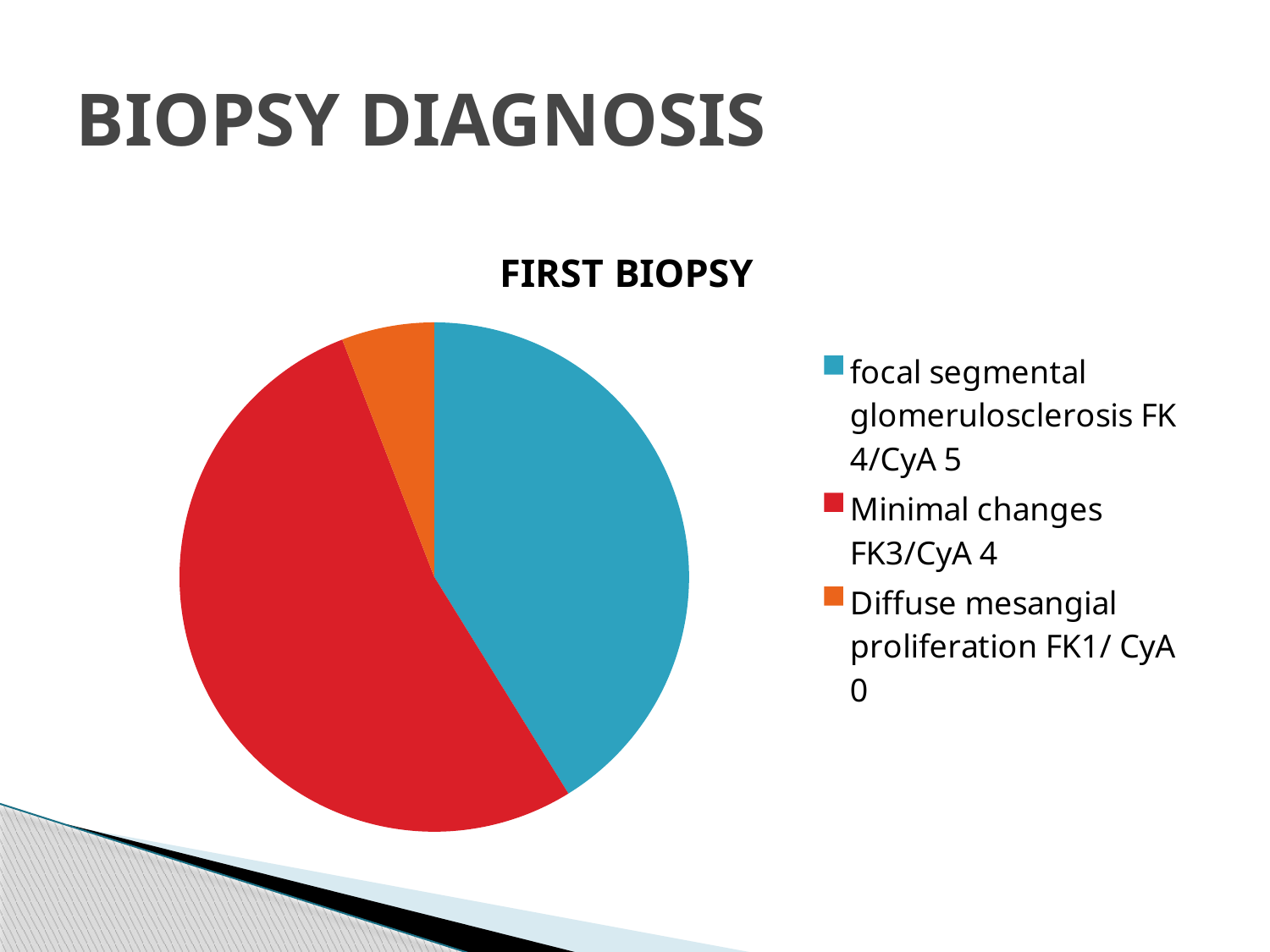
Which category has the smallest slice of the pie chart? Diffuse mesangial proliferation FK1/ CyA 0 What is the title of the pie chart? FIRST BIOPSY How many entries does the legend of the pie chart list? 3 Which colour represents Minimal changes FK3/CyA 4 in the pie chart? red Which slice is larger: focal segmental glomerulosclerosis FK 4/CyA 5 or Minimal changes FK3/CyA 4? Minimal changes FK3/CyA 4 Which category is shown in orange in the pie chart? Diffuse mesangial proliferation FK1/ CyA 0 Which slice is larger: Minimal changes FK3/CyA 4 or Diffuse mesangial proliferation FK1/ CyA 0? Minimal changes FK3/CyA 4 What kind of chart is shown on the slide? pie chart How many slices does the pie chart have? 3 Which category has the largest slice of the pie chart? Minimal changes FK3/CyA 4